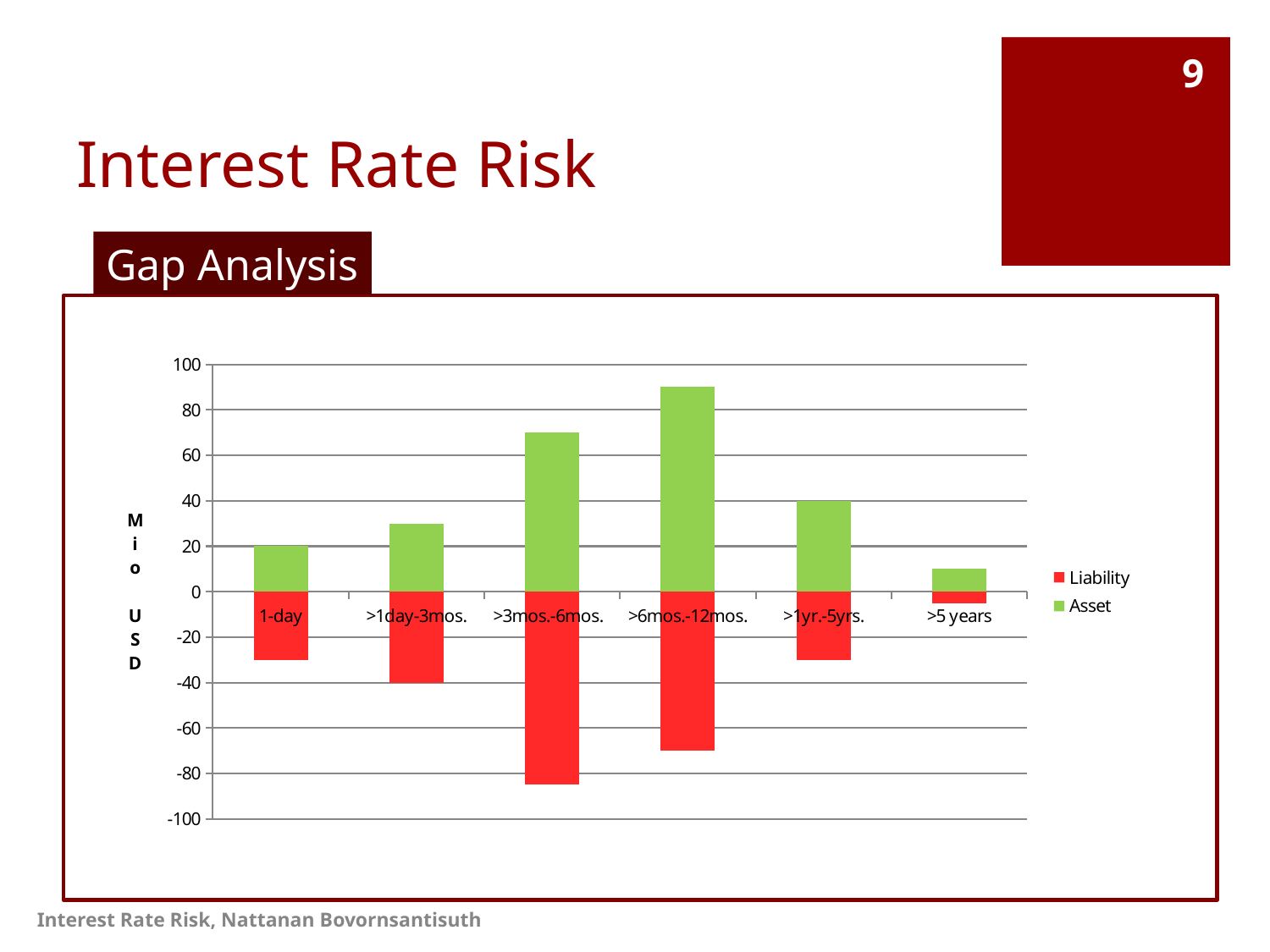
What unit is shown on the vertical axis label? Mio USD Which bucket has the highest Asset value? >6mos.-12mos. Which has the larger Asset value: >3mos.-6mos. or >1yr.-5yrs.? >3mos.-6mos. Which bucket has the lowest Asset value? >5 years Is the Liability value for >3mos.-6mos. greater or less than -80? less What is the Asset value for the 1-day bucket? 20 Is the Asset value for >6mos.-12mos. greater or less than 80? greater What is the Liability value for the >1day-3mos. bucket? -40 What is the Asset value for the >1yr.-5yrs. bucket? 40 What type of chart is shown on the slide? bar chart How many maturity buckets (categories) are shown on the x axis? 6 How many series does the legend list? 2